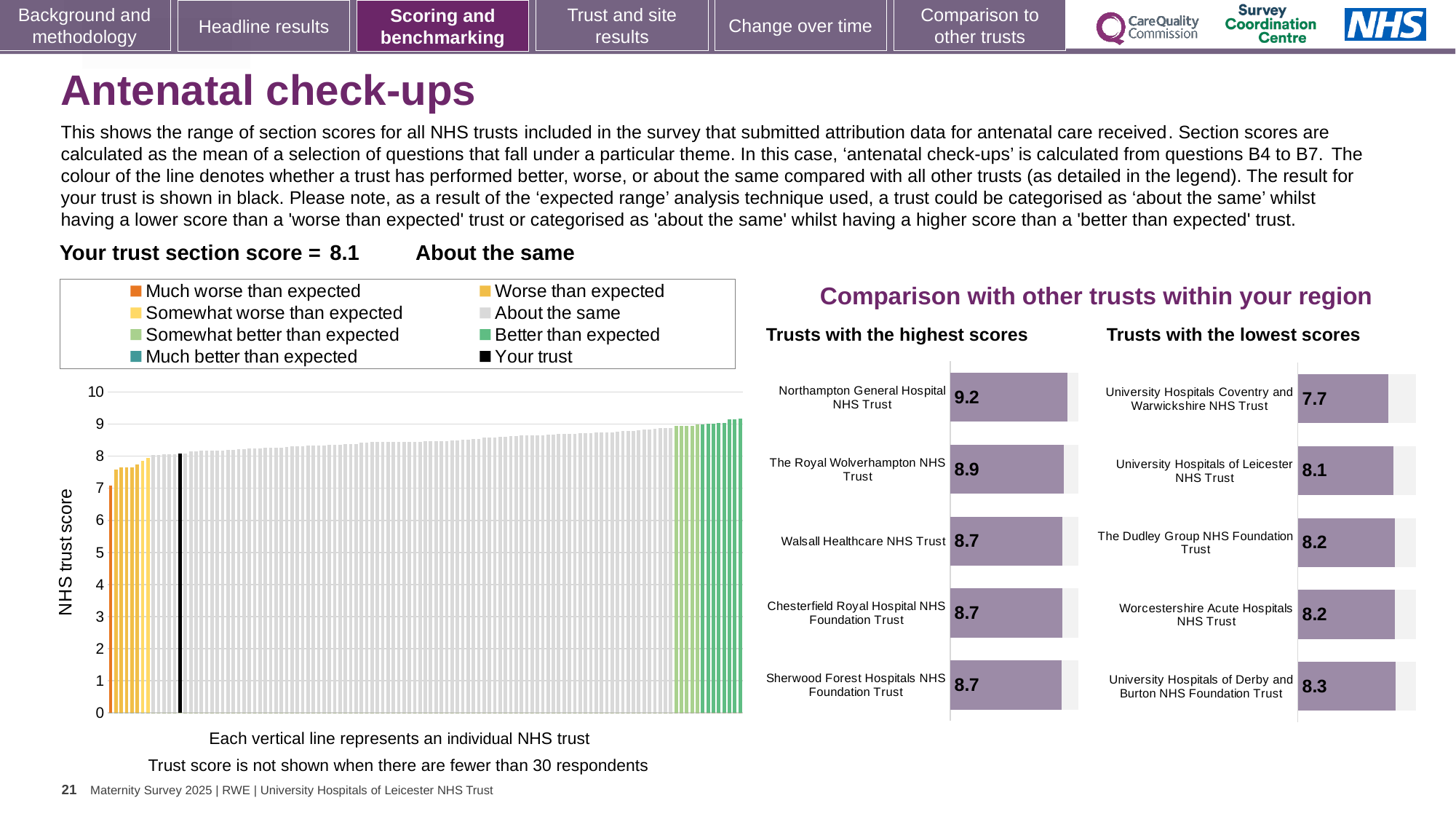
In the large chart on the left, do the trust scores rise or fall from left to right? Rise In the 'Trusts with the lowest scores' chart, what is the score for University Hospitals of Derby and Burton NHS Foundation Trust? 8.3 In the 'Trusts with the lowest scores' chart, which has the larger score: University Hospitals of Leicester NHS Trust or University Hospitals of Derby and Burton NHS Foundation Trust? University Hospitals of Derby and Burton NHS Foundation Trust How many entries does the legend above the large chart on the left list? 8 In the 'Trusts with the highest scores' chart, what is the difference between the scores of Northampton General Hospital NHS Trust and The Royal Wolverhampton NHS Trust? 0.3 In the 'Trusts with the highest scores' chart, what is the score for The Royal Wolverhampton NHS Trust? 8.9 How many trusts are shown in the 'Trusts with the highest scores' chart? 5 In the 'Trusts with the highest scores' chart, what is the score for Northampton General Hospital NHS Trust? 9.2 In the 'Trusts with the lowest scores' chart, which trust has the lowest score? University Hospitals Coventry and Warwickshire NHS Trust In the 'Trusts with the lowest scores' chart, what is the score for University Hospitals Coventry and Warwickshire NHS Trust? 7.7 What kind of chart is the large chart on the left of the slide showing NHS trust scores? Bar chart In the 'Trusts with the highest scores' chart, which trust has the highest score? Northampton General Hospital NHS Trust